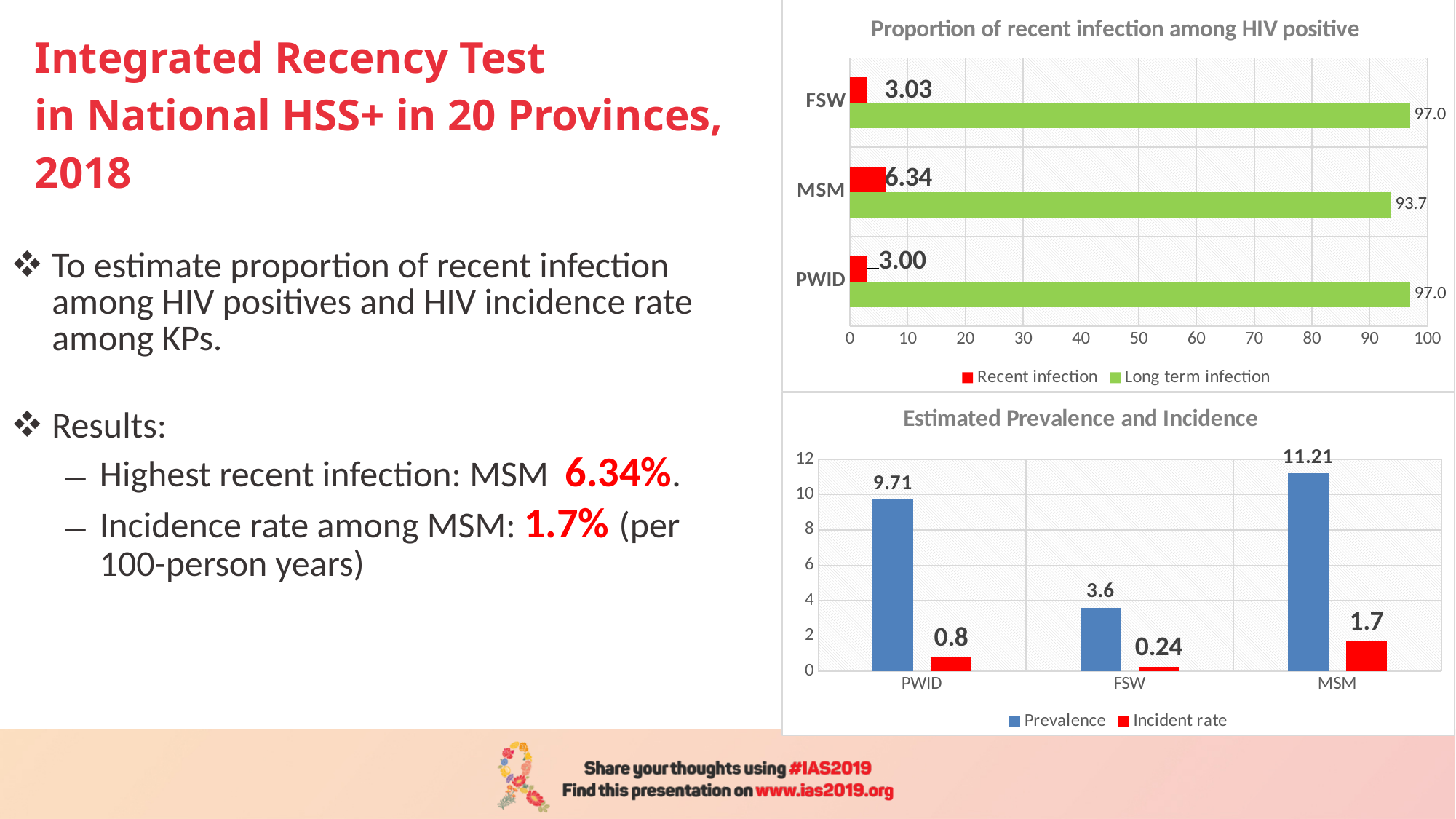
In the 'Estimated Prevalence and Incidence' chart, is the Prevalence for MSM or PWID larger? MSM In the 'Proportion of recent infection among HIV positive' chart, what is the difference between the Recent infection values for MSM and FSW? 3.31 In the 'Proportion of recent infection among HIV positive' chart, what is the Long term infection value for MSM? 93.7 In the 'Proportion of recent infection among HIV positive' chart, how many series does the legend list? 2 What kind of chart is 'Estimated Prevalence and Incidence'? Bar chart In the 'Estimated Prevalence and Incidence' chart, what is the Incident rate for FSW? 0.24 In the 'Estimated Prevalence and Incidence' chart, which group has the highest Prevalence? MSM In the 'Estimated Prevalence and Incidence' chart, what is the Prevalence value for PWID? 9.71 In the 'Proportion of recent infection among HIV positive' chart, what is the Recent infection value for MSM? 6.34 In the 'Proportion of recent infection among HIV positive' chart, which group has the highest Recent infection value? MSM In the 'Proportion of recent infection among HIV positive' chart, which group has the lowest Recent infection value? PWID In the 'Estimated Prevalence and Incidence' chart, how many groups are shown on the x axis? 3